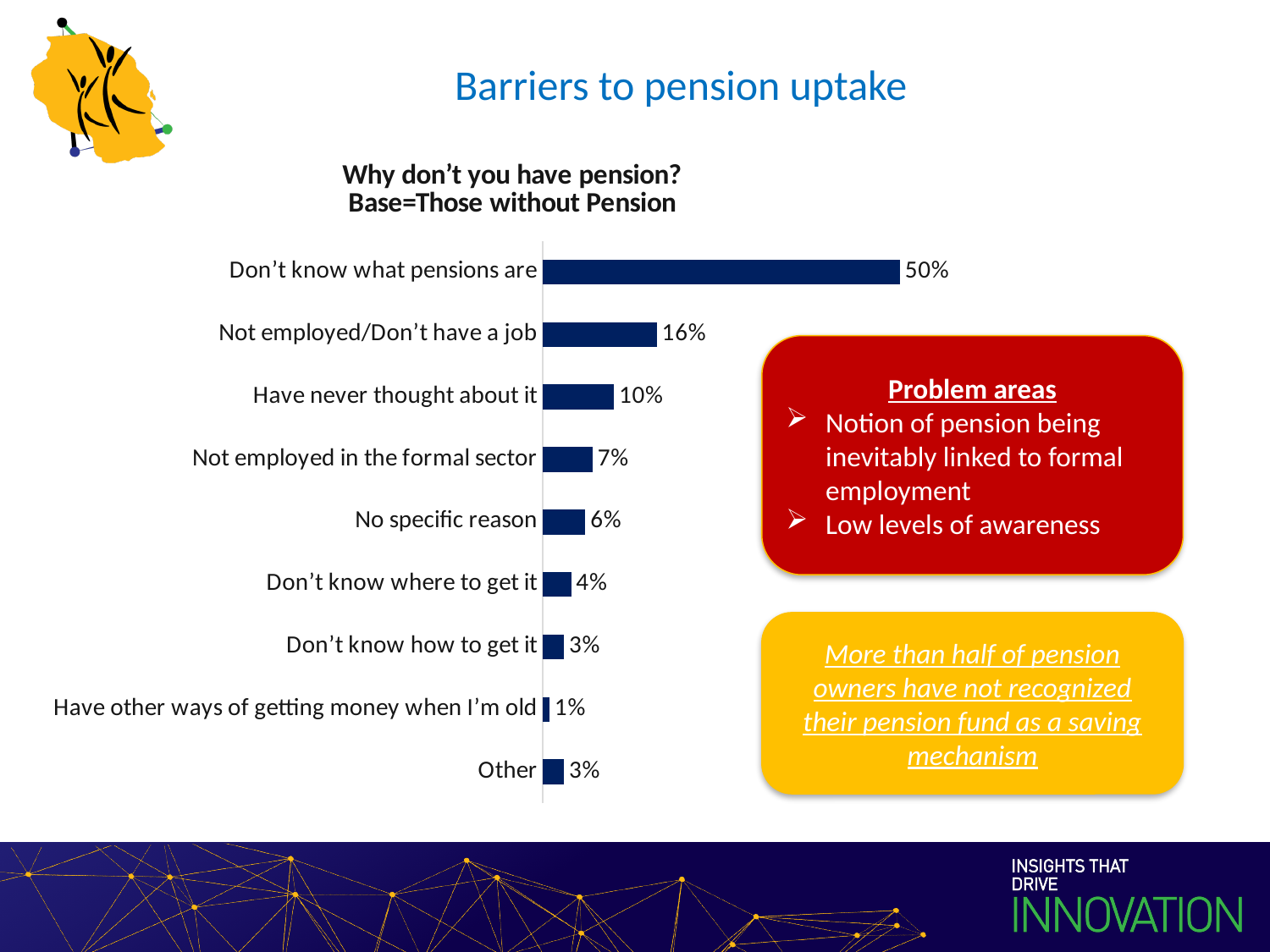
Which reason has the highest percentage? Don't know what pensions are Which reason has the lowest percentage? Have other ways of getting money when I'm old How many reasons (categories) are shown in the chart? 9 What is the title of the chart? Why don't you have pension? Base=Those without Pension What type of chart is used to show the reasons for not having a pension? Bar chart What is the value for "Have other ways of getting money when I'm old"? 1% What is the difference between "Don't know where to get it" and "Don't know how to get it"? 1 percentage point What percentage gave "Have never thought about it" as a reason? 10% What is the difference between "Don't know what pensions are" and "Not employed/Don't have a job"? 34 percentage points Which is larger: "Not employed in the formal sector" or "No specific reason"? Not employed in the formal sector What is the value for "Not employed/Don't have a job"? 16% What percentage of respondents said they don't know what pensions are? 50%